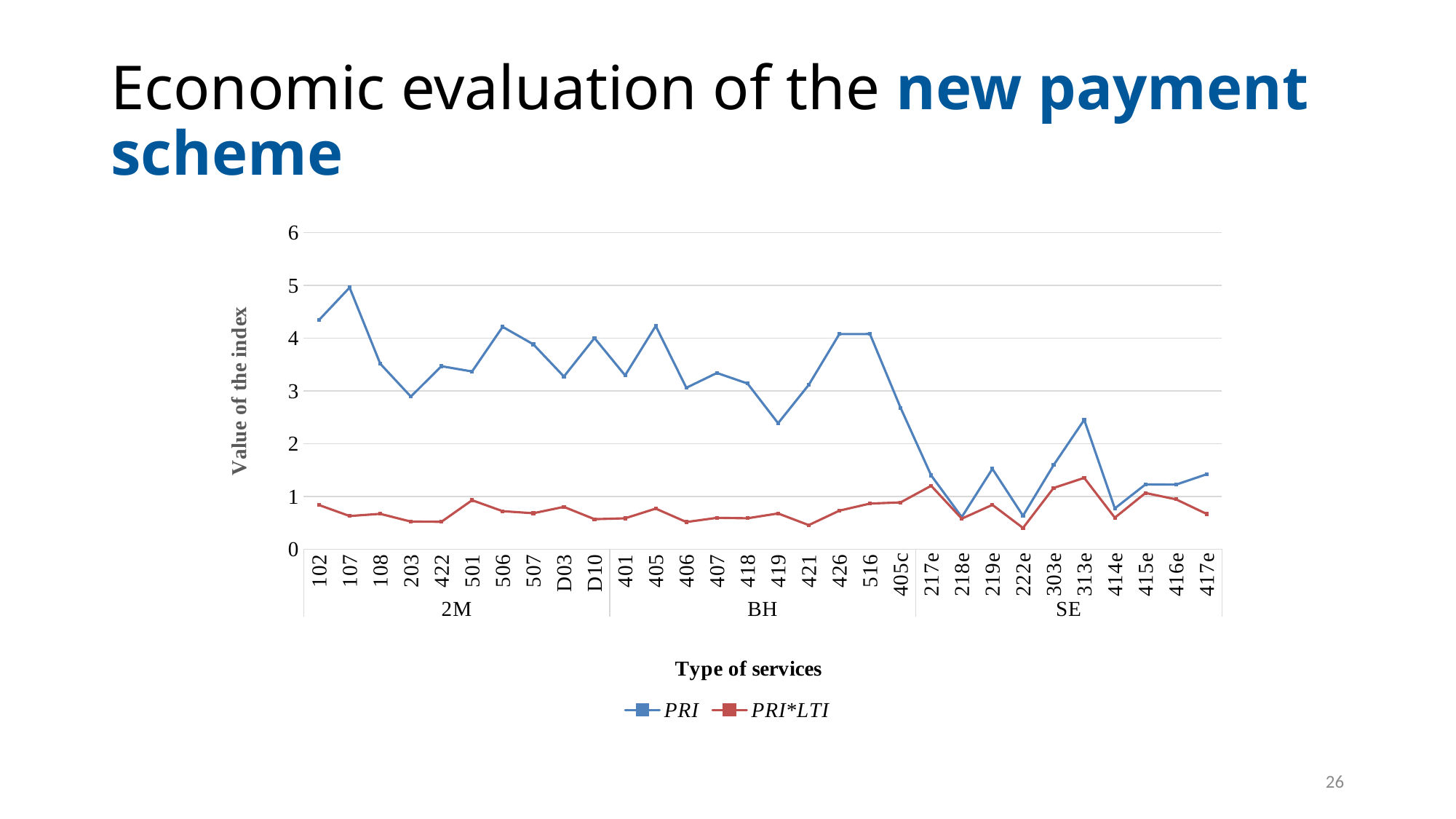
Is the PRI*LTI value for service 405 greater or less than 1? less Is the PRI value for service 419 greater or less than 3? less How many service groups are labelled along the x axis? 3 What is the title of the y axis? Value of the index Which is larger, the PRI value for service 107 or for service 108? 107 How many series does the legend list? 2 Is the PRI value for service 107 greater or less than 4? greater Which series has the higher value for service 426, PRI or PRI*LTI? PRI How many service categories are plotted along the x axis? 30 What kind of chart is shown on the slide? line chart For which service is the PRI value highest? 107